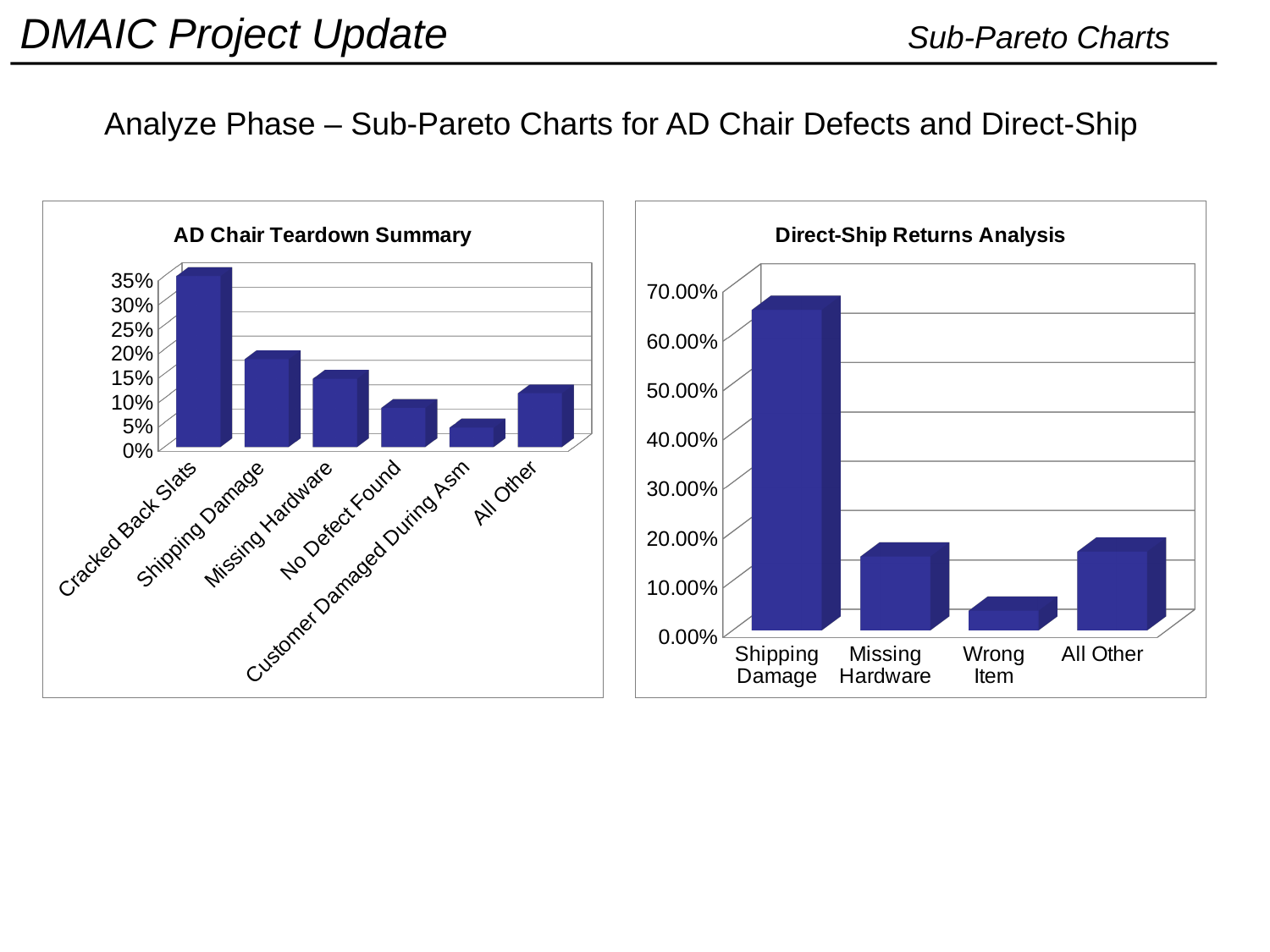
How many categories are shown in the AD Chair Teardown Summary chart? 6 In the Direct-Ship Returns Analysis chart, is the value for Shipping Damage greater or less than 60.00%? greater In the AD Chair Teardown Summary chart, which category has the lowest value? Customer Damaged During Asm In the AD Chair Teardown Summary chart, which is larger: Shipping Damage or All Other? Shipping Damage In the Direct-Ship Returns Analysis chart, is the value for Wrong Item greater or less than 10.00%? less In the AD Chair Teardown Summary chart, is the value for Cracked Back Slats greater or less than 30%? greater What type of chart is the AD Chair Teardown Summary? bar chart How many categories are shown in the Direct-Ship Returns Analysis chart? 4 In the AD Chair Teardown Summary chart, which category has the highest value? Cracked Back Slats In the Direct-Ship Returns Analysis chart, which category has the lowest value? Wrong Item In the Direct-Ship Returns Analysis chart, which category has the highest value? Shipping Damage